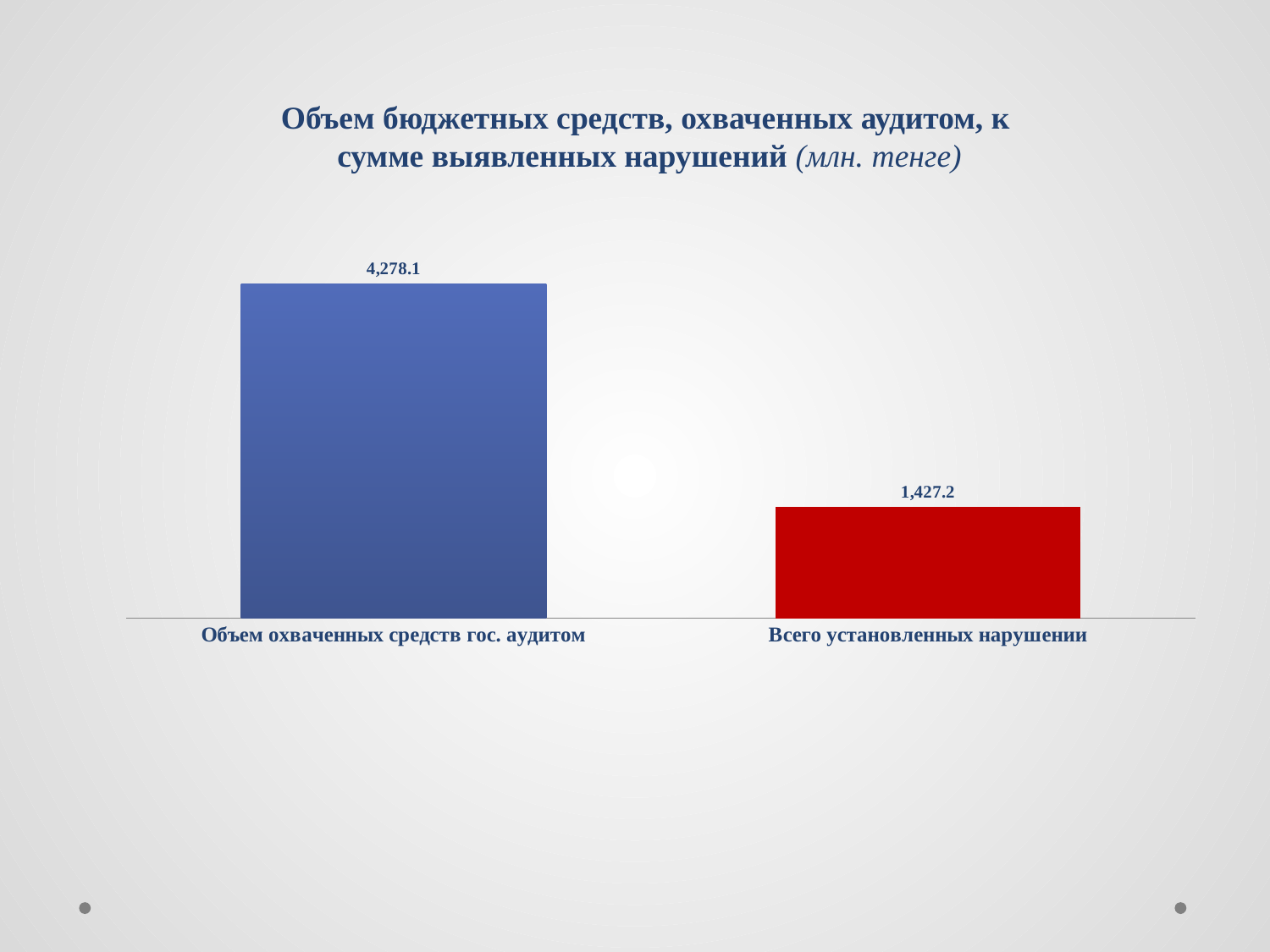
What kind of chart is shown on the slide? Bar chart What is the title of the chart? Объем бюджетных средств, охваченных аудитом, к сумме выявленных нарушений (млн. тенге) Which category has the lowest value? Всего установленных нарушении What is the difference between the value for "Объем охваченных средств гос. аудитом" and the value for "Всего установленных нарушении"? 2,850.9 What colour is the bar for "Всего установленных нарушении"? Red Which is larger: the value for "Объем охваченных средств гос. аудитом" or the value for "Всего установленных нарушении"? Объем охваченных средств гос. аудитом What is the value for "Всего установленных нарушении"? 1,427.2 How many categories are shown in the chart? 2 What is the value for "Объем охваченных средств гос. аудитом"? 4,278.1 What unit is stated in the chart title? млн. тенге Which category has the highest value? Объем охваченных средств гос. аудитом